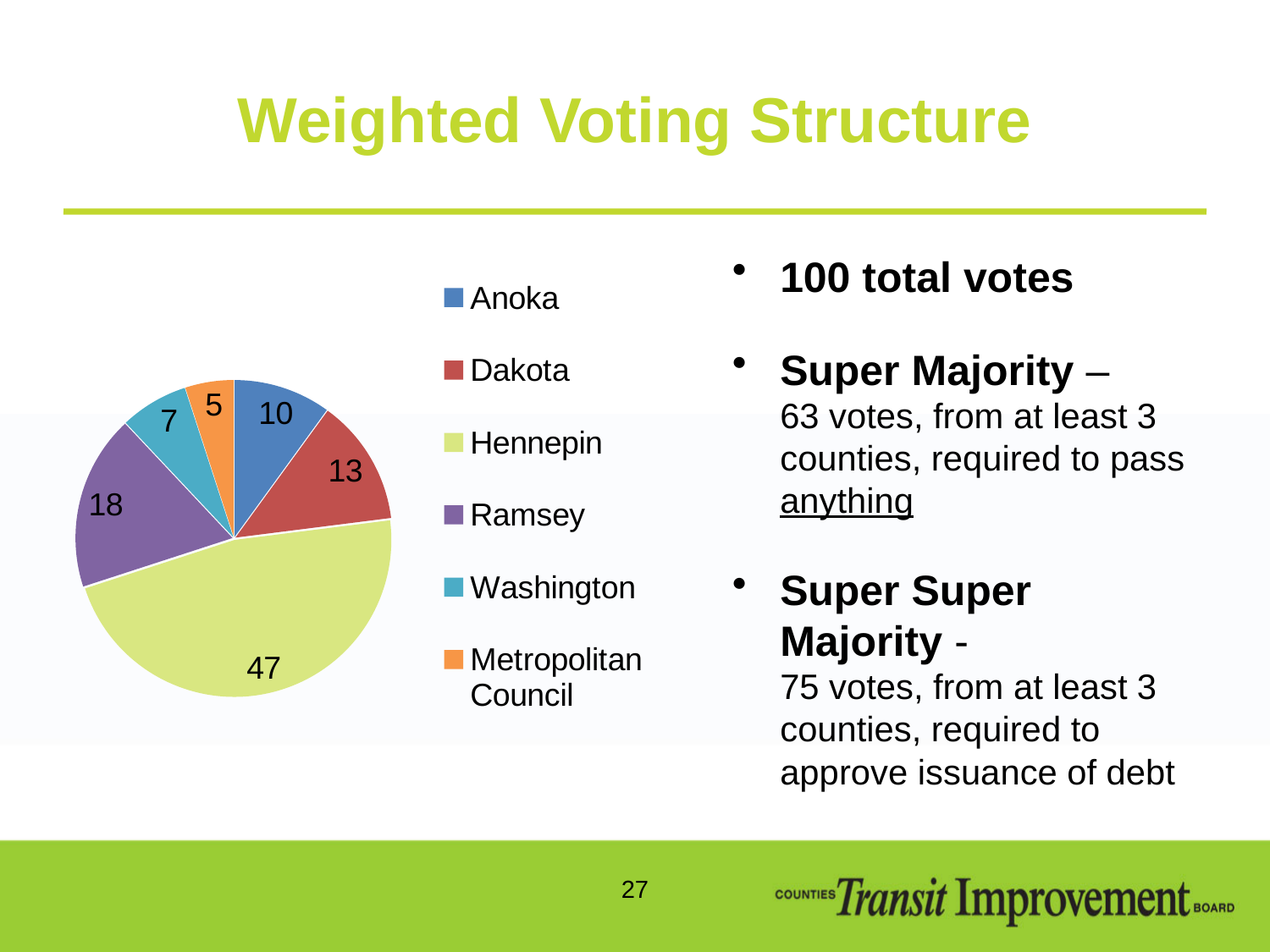
What value is shown for Metropolitan Council in the pie chart? 5 What share of the pie does Hennepin represent, given the slices total 100? 47% Which is larger, the value for Anoka or the value for Washington? Anoka What value is shown for Hennepin in the pie chart? 47 Which category has the largest slice of the pie chart? Hennepin What type of chart is shown on the slide? Pie chart What is the difference between the values for Hennepin and Ramsey? 29 How many categories are shown in the pie chart? 6 Which category has the smallest slice of the pie chart? Metropolitan Council What value is shown for Dakota in the pie chart? 13 What value is shown for Ramsey in the pie chart? 18 What is the title of the slide containing the pie chart? Weighted Voting Structure